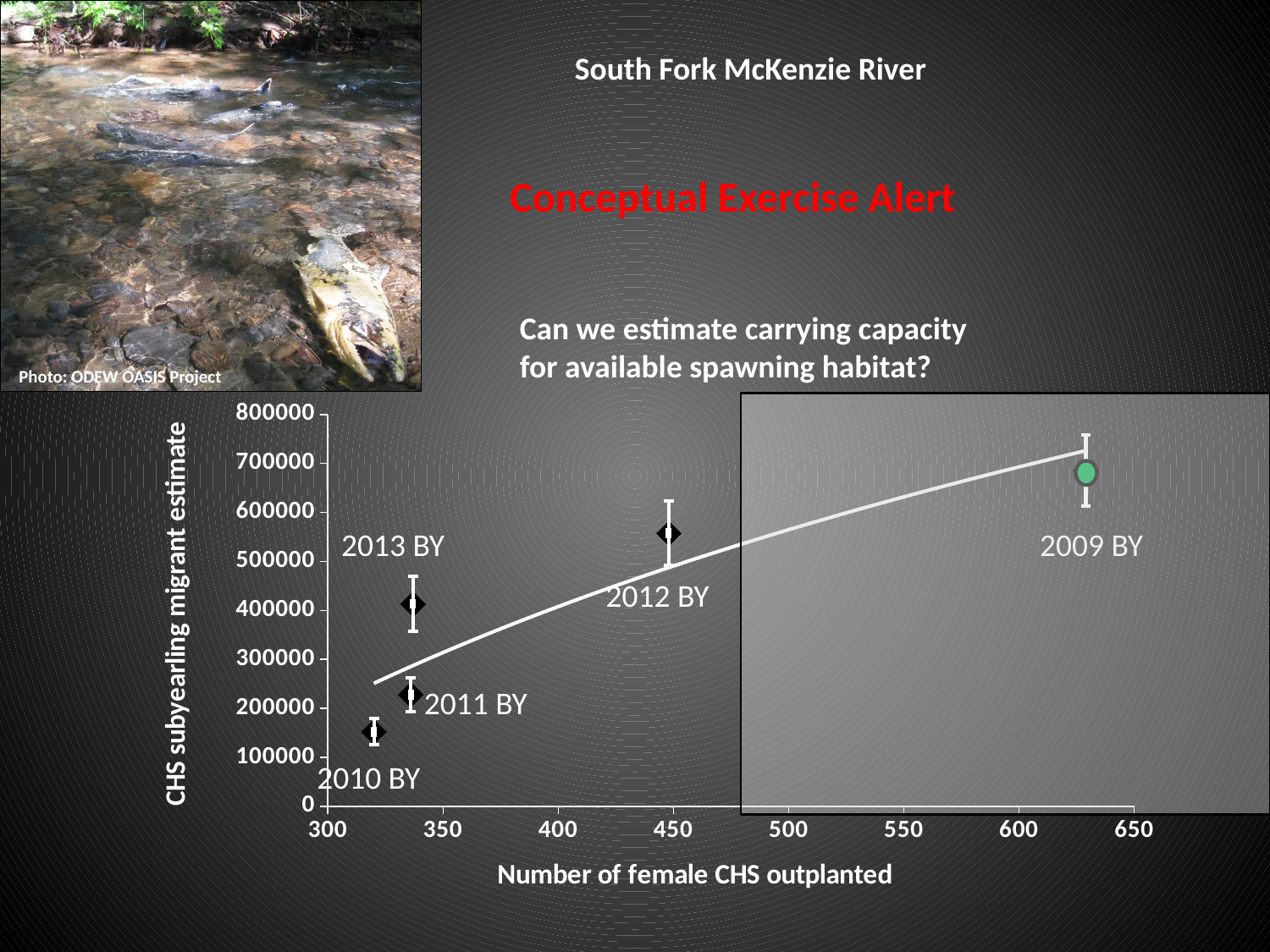
Which brood year has the lowest CHS subyearling migrant estimate? 2010 BY How many brood-year data points are plotted on the chart? 5 Is the CHS subyearling migrant estimate for 2013 BY greater or less than 300000? greater What kind of chart is shown on the slide? scatter plot What is the title of the x axis of the chart? Number of female CHS outplanted Which has the larger CHS subyearling migrant estimate, 2012 BY or 2013 BY? 2012 BY Is the CHS subyearling migrant estimate for 2009 BY greater or less than 600000? greater Which brood year has the highest CHS subyearling migrant estimate? 2009 BY Does the fitted line rise or fall as the number of female CHS outplanted increases? rises Is the CHS subyearling migrant estimate for 2012 BY greater or less than 500000? greater What is the title of the y axis of the chart? CHS subyearling migrant estimate